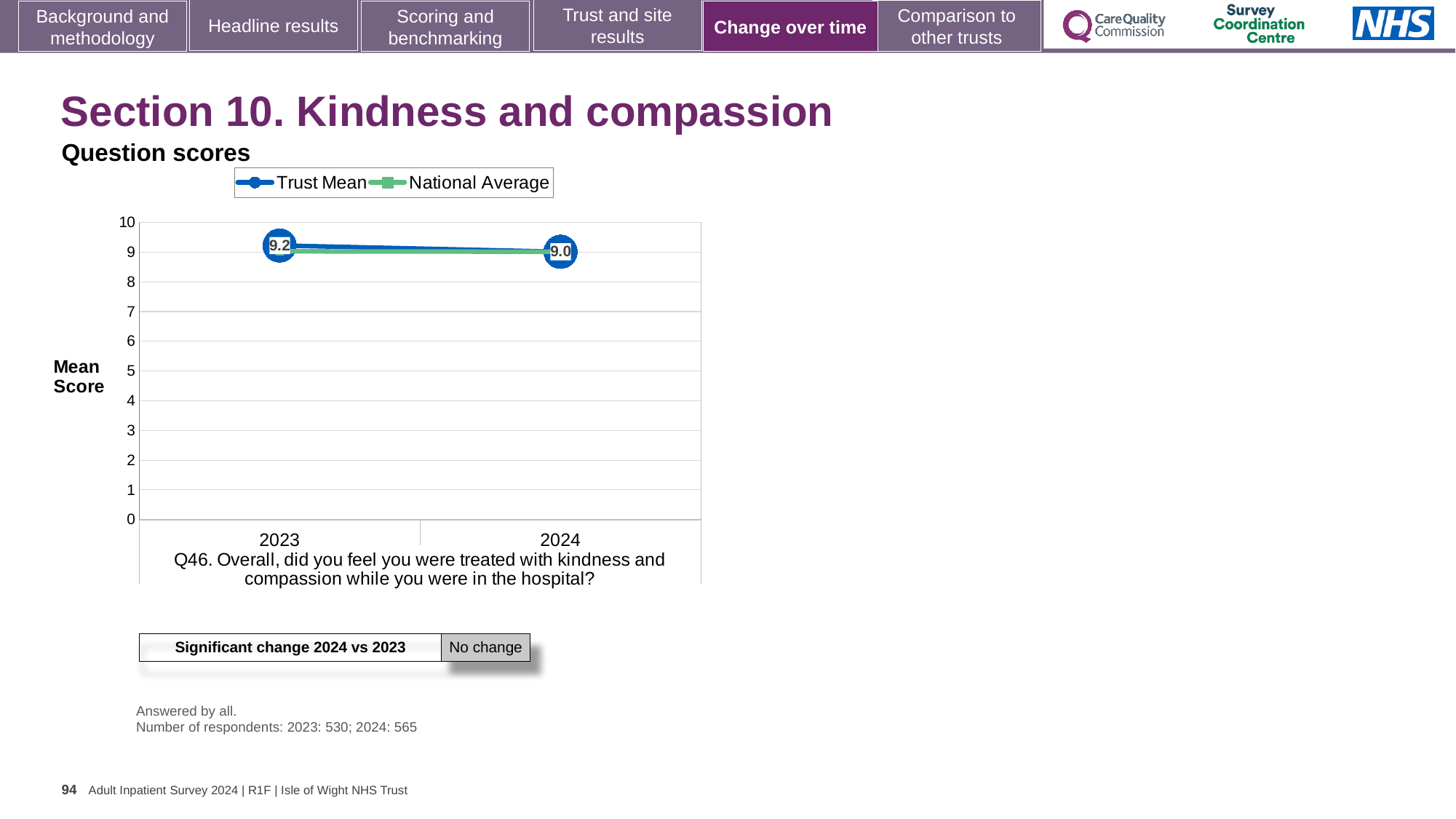
Is the National Average value for 2024 greater or less than 5? greater By how much did the Trust Mean score change from 2023 to 2024? 0.2 What is the Trust Mean score for 2023? 9.2 Does the Trust Mean rise or fall from 2023 to 2024? fall What is the Trust Mean score for 2024? 9.0 Which year has the higher Trust Mean score, 2023 or 2024? 2023 Is the Trust Mean value for 2023 greater or less than 8? greater How many series does the legend list? 2 What are the two series named in the legend? Trust Mean and National Average What is the label on the y axis of the chart? Mean Score How many years are plotted on the x axis? 2 What kind of chart is shown on the slide? line chart